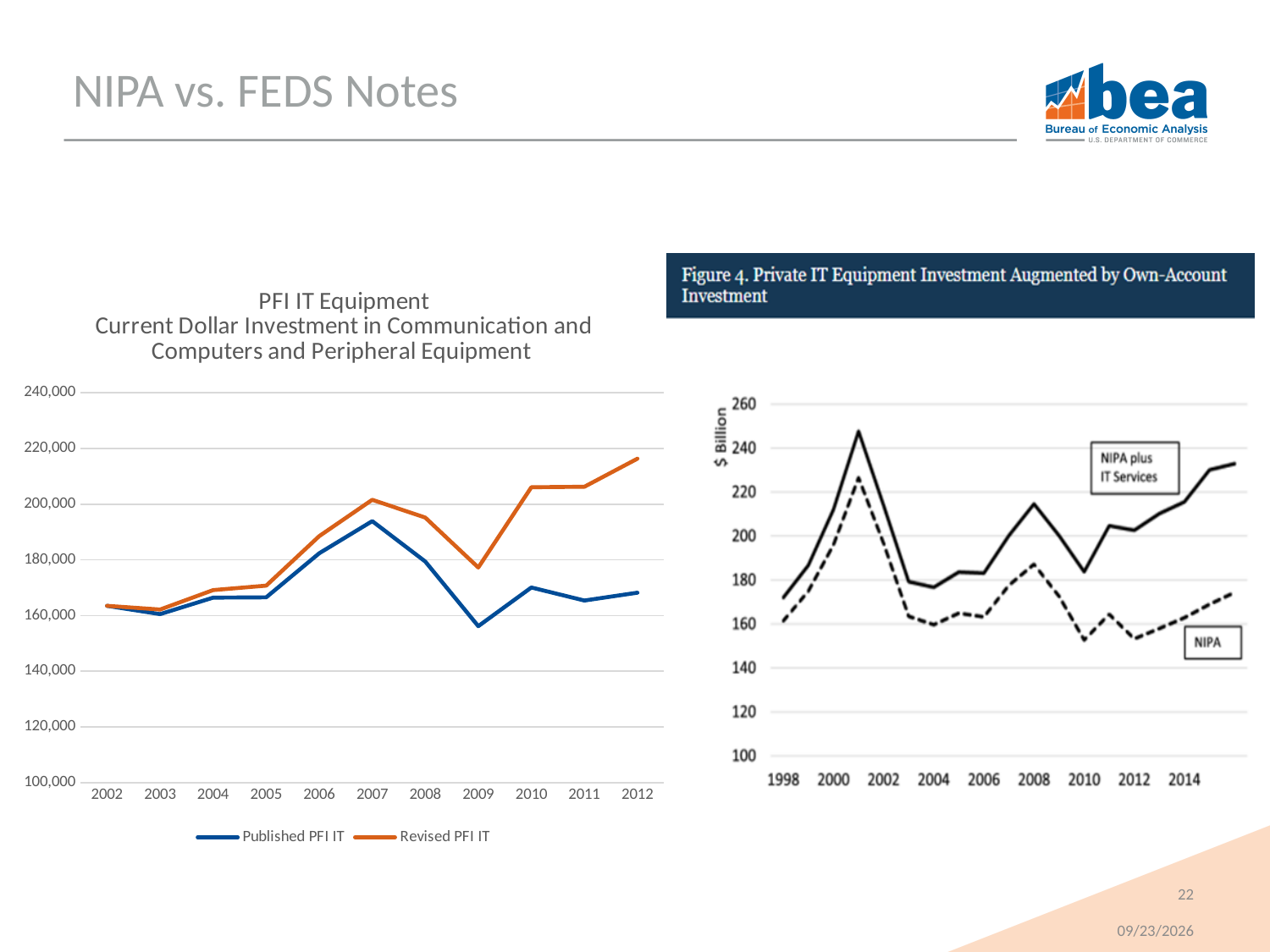
In the right chart (Figure 4), is the value for NIPA in 2010 greater or less than 160? less In the left chart (PFI IT Equipment), which series has the larger value in 2012, Published PFI IT or Revised PFI IT? Revised PFI IT What kind of chart is the left chart titled "PFI IT Equipment Current Dollar Investment in Communication and Computers and Peripheral Equipment"? Line chart In the left chart (PFI IT Equipment), is the value for Published PFI IT in 2009 greater or less than 160,000? less In the right chart (Figure 4), is the value for NIPA plus IT Services in 2001 greater or less than 240? greater In the left chart (PFI IT Equipment), in which year is the Published PFI IT series lowest? 2009 In the left chart (PFI IT Equipment), in which year is the Revised PFI IT series highest? 2012 What is the y-axis unit label on the right chart (Figure 4)? $ Billion In the left chart (PFI IT Equipment), in which year is the Published PFI IT series highest? 2007 How many series does the legend of the left chart (PFI IT Equipment) list? 2 How many years are shown on the x axis of the left chart (PFI IT Equipment)? 11